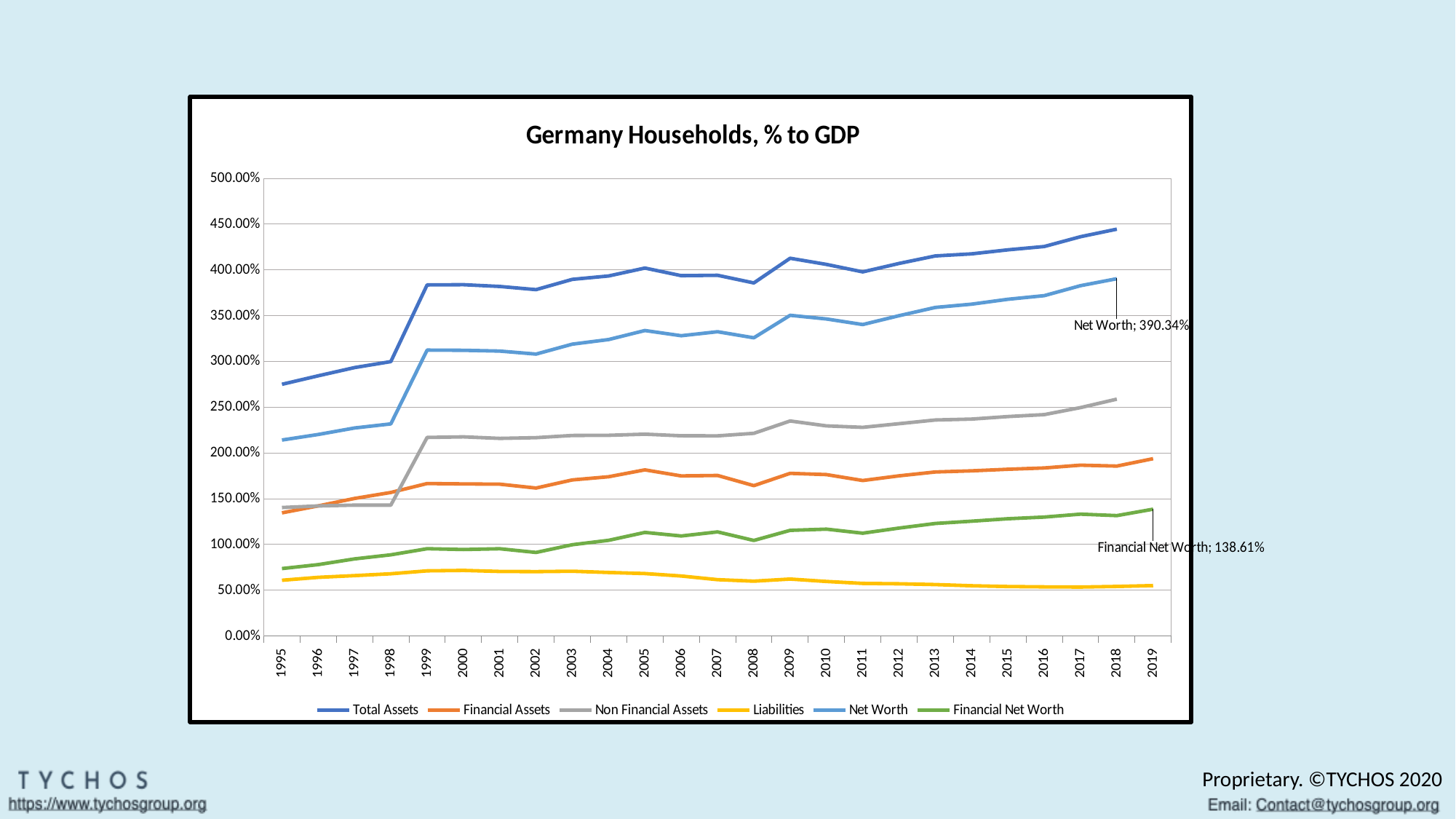
What is the value of Financial Net Worth in 2019? 138.61% Which series has the highest value in 2019? Financial Assets What kind of chart is shown on the slide? Line chart Which series has the lowest value in 2019? Liabilities How many years are shown on the x axis? 25 How many series does the legend list? 6 Does Total Assets rise or fall overall from 1995 to 2019? Rise What is the title of the chart? Germany Households, % to GDP